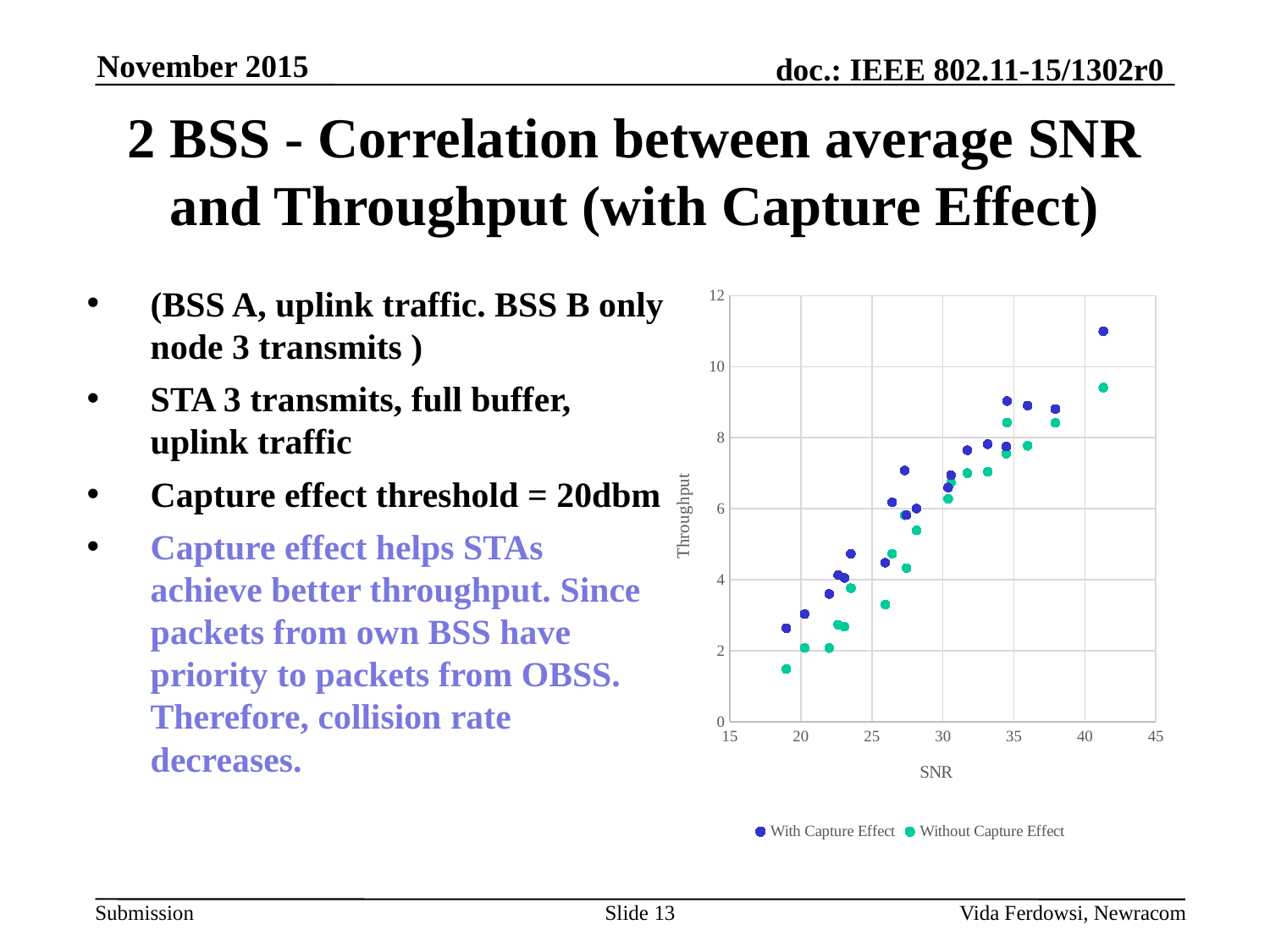
What are the two series named in the chart's legend? With Capture Effect and Without Capture Effect Is the highest throughput value for the Without Capture Effect series greater or less than 10? less Which series contains the point with the highest throughput on the chart? With Capture Effect As SNR increases along the x axis, does throughput rise or fall? Rise Is the highest throughput value for the With Capture Effect series greater or less than 10? greater Does the With Capture Effect series generally lie above or below the Without Capture Effect series? Above What kind of chart is shown on the slide? Scatter chart How many series does the chart's legend list? 2 What are the titles of the x axis and y axis of the chart? SNR (x axis) and Throughput (y axis) Is the lowest throughput value for the Without Capture Effect series greater or less than 2? less At the highest SNR plotted (around 41), which series has the higher throughput? With Capture Effect